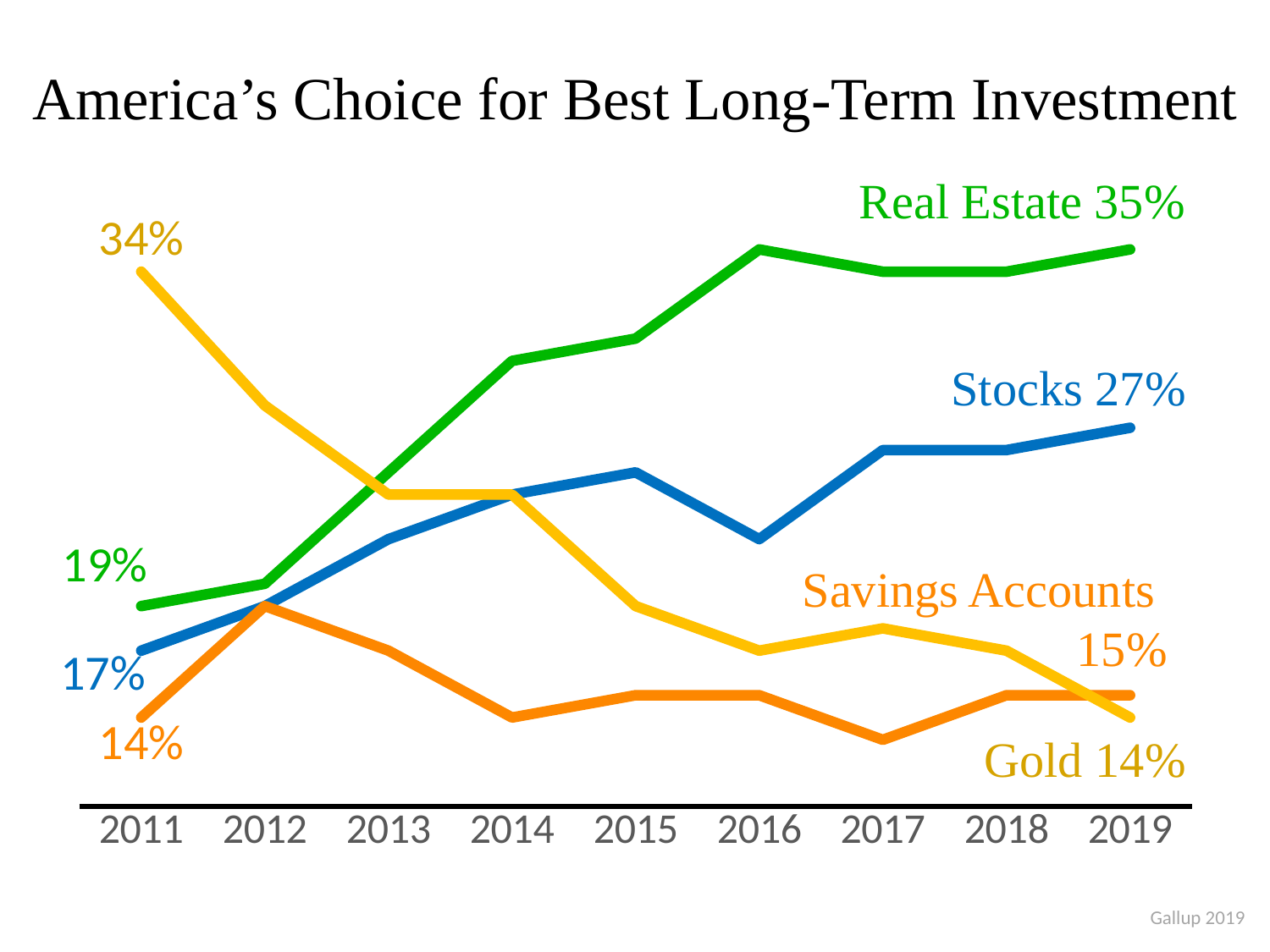
How many years are shown on the x axis? 9 Which was larger in 2011, the value for Real Estate or the value for Stocks? Real Estate What percentage of Americans chose Gold as the best long-term investment in 2011? 34% What is the value for Stocks in 2019? 27% What kind of chart is shown on the slide? Line chart Which investment has the lowest value in 2011? Savings Accounts Which investment has the highest value in 2019? Real Estate Does the value for Gold generally rise or fall from 2011 to 2019? Fall How many investment types (series) are plotted on the chart? 4 What is the value for Real Estate in 2019? 35% What is the value for Savings Accounts in 2011? 14% By how many percentage points did Real Estate's value change from 2011 to 2019? 16 percentage points